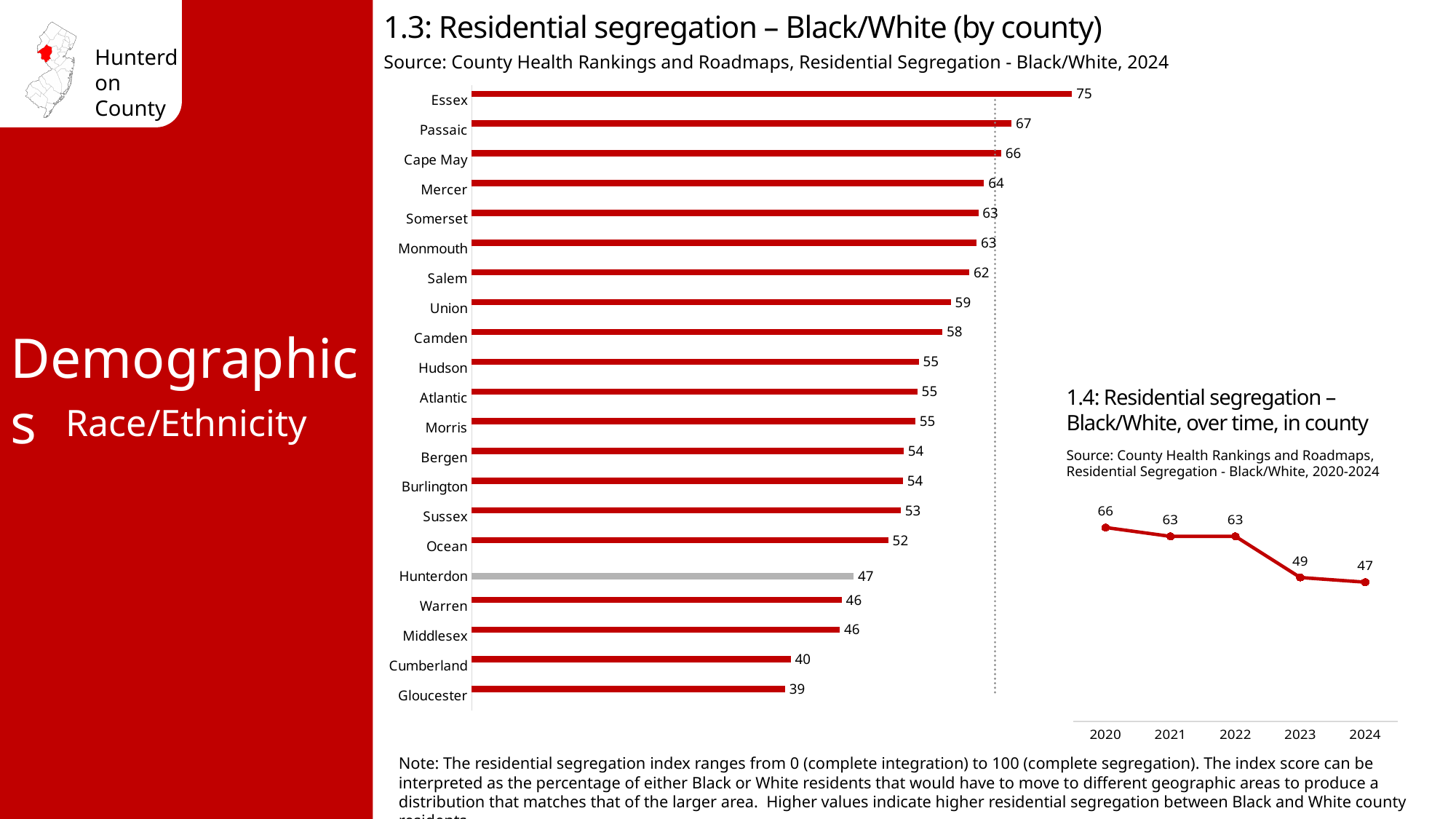
In chart 1.4 (over time, in county), how many years are plotted? 5 In chart 1.4 (over time, in county), what is the difference between the 2022 and 2023 values? 14 In chart 1.3 (by county), which county has the highest value? Essex What kind of chart is chart 1.3 (by county)? Bar chart In chart 1.3 (by county), which has a larger value, Passaic or Mercer? Passaic In chart 1.4 (over time, in county), what is the value for 2020? 66 In chart 1.4 (over time, in county), do the values rise or fall from 2020 to 2024? Fall In chart 1.3 (by county), which county has the lowest value? Gloucester In chart 1.3 (by county), how many counties are shown? 21 In chart 1.3 (by county), what is the difference between the values for Essex and Gloucester? 36 In chart 1.3 (Residential segregation – Black/White by county), what is the value for Hunterdon? 47 In chart 1.3 (by county), what is the value for Cumberland? 40